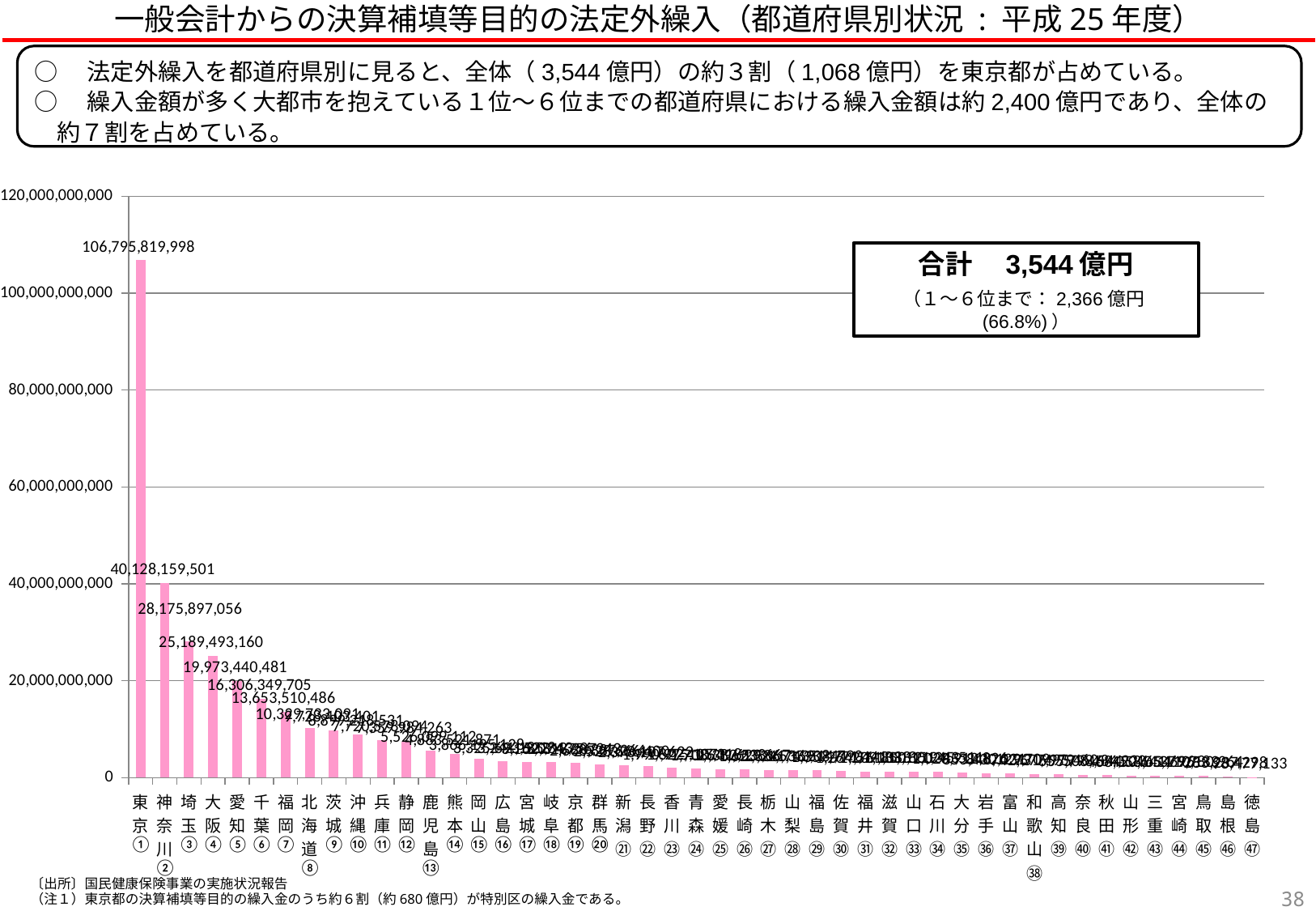
Which prefecture has the lowest value in the bar chart? 徳島 Which prefecture has the highest value in the bar chart? 東京 Is the value for 北海道 greater or less than 20,000,000,000? less Which has the larger value, 埼玉 or 大阪? 埼玉 How many prefectures are shown on the x axis of the bar chart? 47 What is the value for 東京 in the bar chart? 106,795,819,998 What is the value for 福岡 in the bar chart? 13,653,510,486 What total amount is shown in the box on the chart (合計)? 3,544 億円 What is the difference between the values for 東京 and 神奈川? 66,667,660,497 What is the value for 神奈川 in the bar chart? 40,128,159,501 What is the value for 大阪 in the bar chart? 25,189,493,160 What is the value for 千葉 in the bar chart? 16,306,349,705